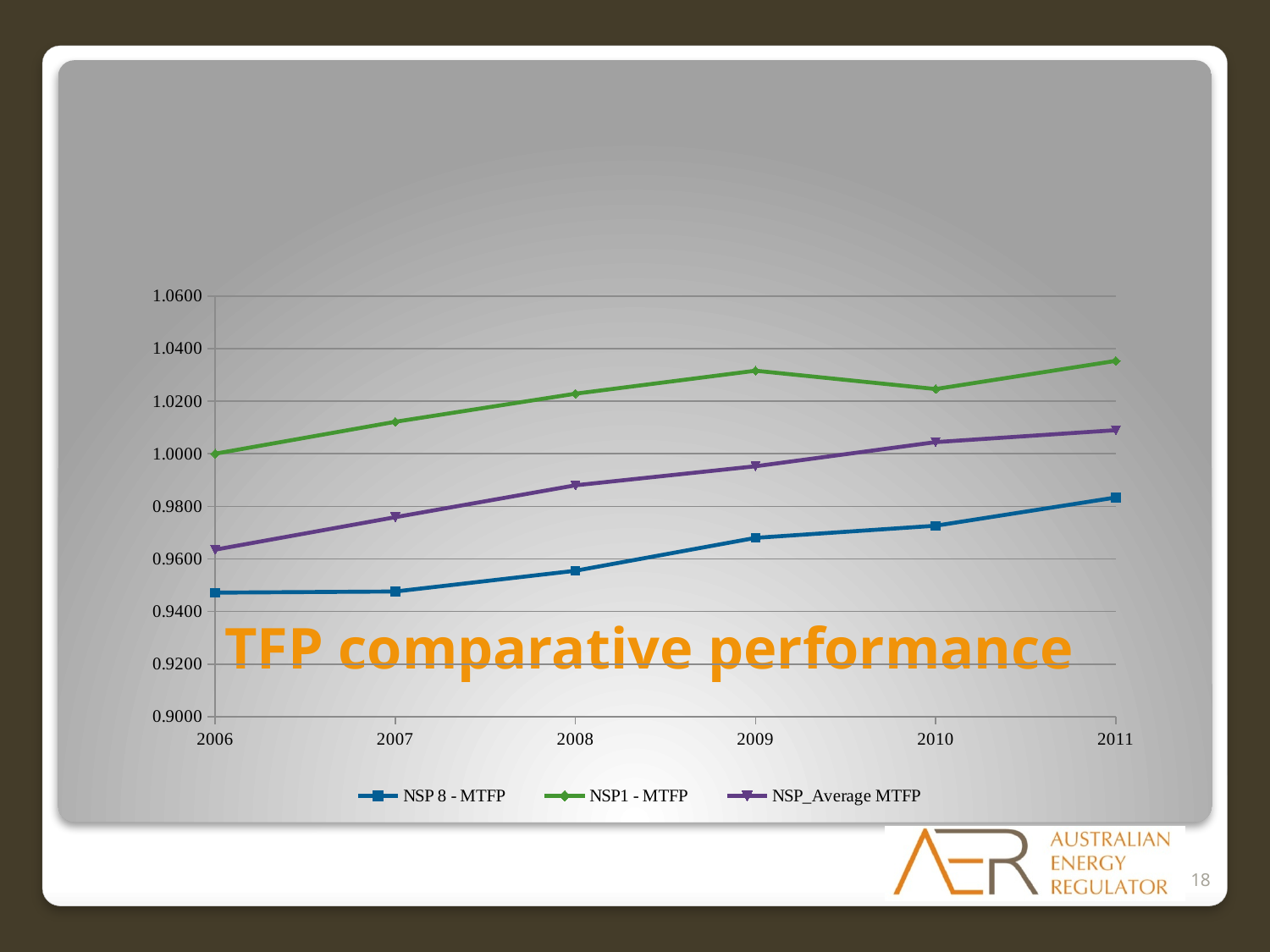
What is the value of NSP1 - MTFP in 2006? 1.0000 Which series has the lowest value in 2006? NSP 8 - MTFP How many series does the legend list? 3 Is the value for NSP1 - MTFP in 2011 greater or less than 1.0200? greater What is the title of the chart? TFP comparative performance Which series has the highest value in 2011? NSP1 - MTFP What kind of chart is shown on the slide? line chart Does the NSP 8 - MTFP series generally rise or fall from 2006 to 2011? rise Is the value for NSP 8 - MTFP in 2006 greater or less than 0.9600? less For NSP1 - MTFP, which year has the larger value, 2009 or 2010? 2009 How many years are shown on the x axis? 6 Is the value for NSP_Average MTFP in 2006 greater or less than 0.9800? less